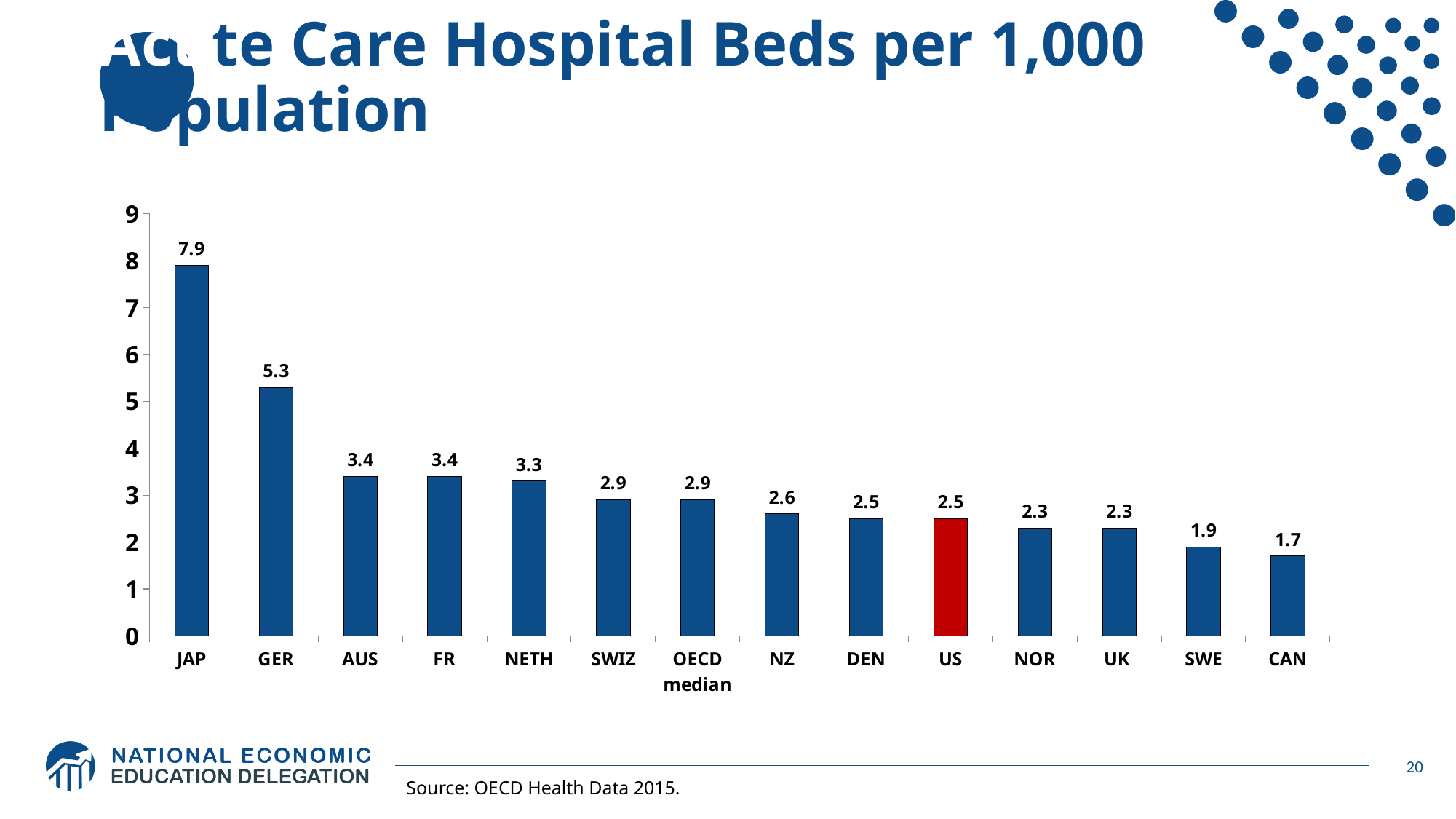
What is the value for JAP? 7.9 What is the difference between the values for the OECD median and the US? 0.4 What is the value for the OECD median? 2.9 How many bars are shown in the chart? 14 Which country has the highest number of acute care hospital beds per 1,000 population? JAP Which country has the lowest number of acute care hospital beds per 1,000 population? CAN What is the value for the US? 2.5 Which bar is coloured red instead of blue? US What is the difference between the values for JAP and GER? 2.6 Which has a larger value, NZ or SWE? NZ Which has a larger value, GER or AUS? GER What kind of chart is shown on the slide? Bar chart